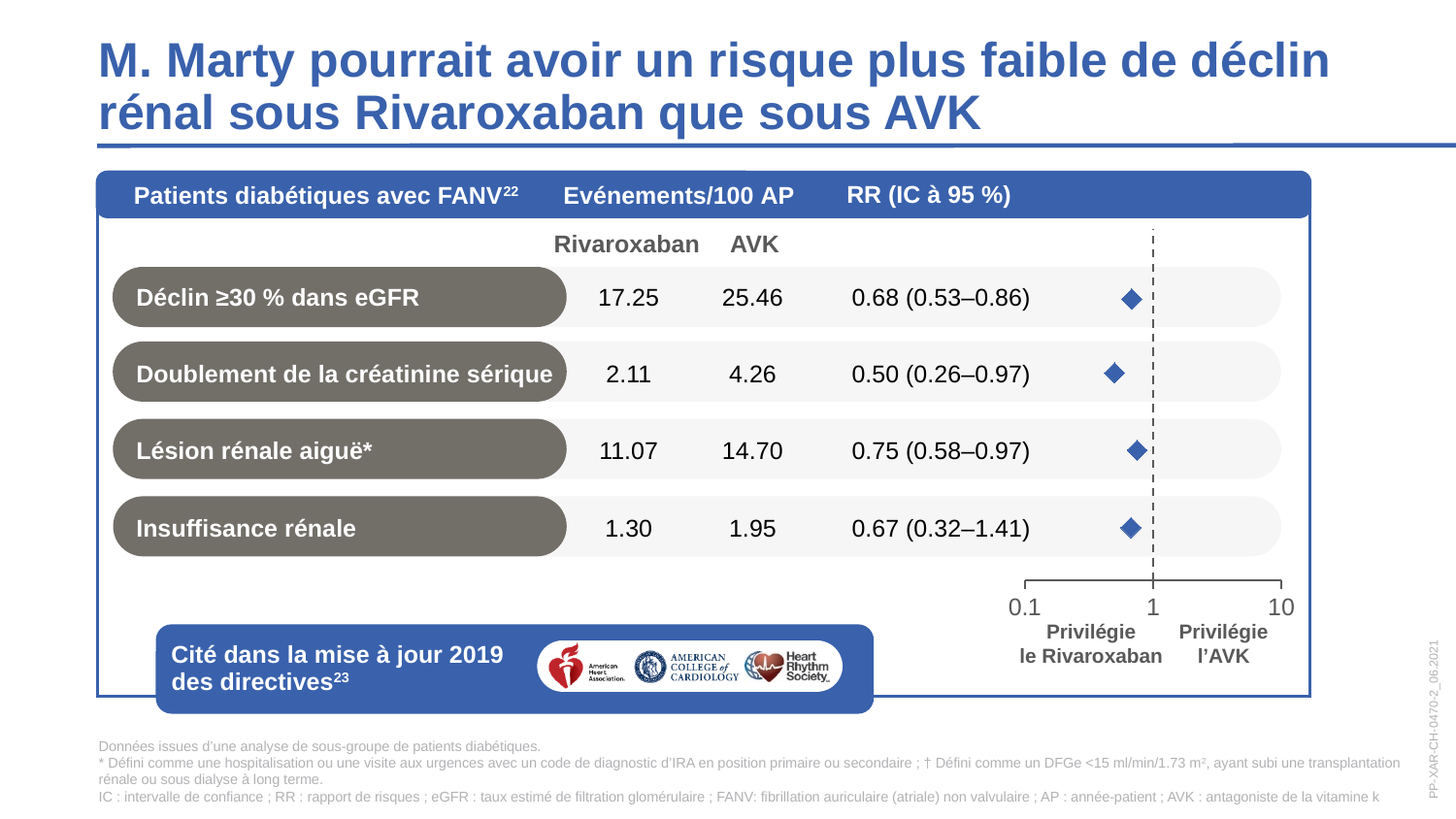
According to the axis label, which treatment is favoured when the RR is to the left of 1? Rivaroxaban What is the difference between the AVK and Rivaroxaban event rates for Déclin ≥30 % dans eGFR? 8.21 What is the AVK event rate (Evénements/100 AP) for Doublement de la créatinine sérique? 4.26 What is the Rivaroxaban event rate (Evénements/100 AP) for Lésion rénale aiguë*? 11.07 Is the RR point estimate for Lésion rénale aiguë* greater or less than 1? less What kind of chart is shown on the right side of the table? Forest plot Which outcome has the lowest RR point estimate? Doublement de la créatinine sérique Which outcome has the highest AVK event rate per 100 AP? Déclin ≥30 % dans eGFR For Insuffisance rénale, which has the higher event rate per 100 AP, Rivaroxaban or AVK? AVK What is the RR (IC à 95 %) for Insuffisance rénale? 0.67 (0.32–1.41) How many outcomes are plotted in the forest plot? 4 What is the RR (IC à 95 %) for Déclin ≥30 % dans eGFR? 0.68 (0.53–0.86)